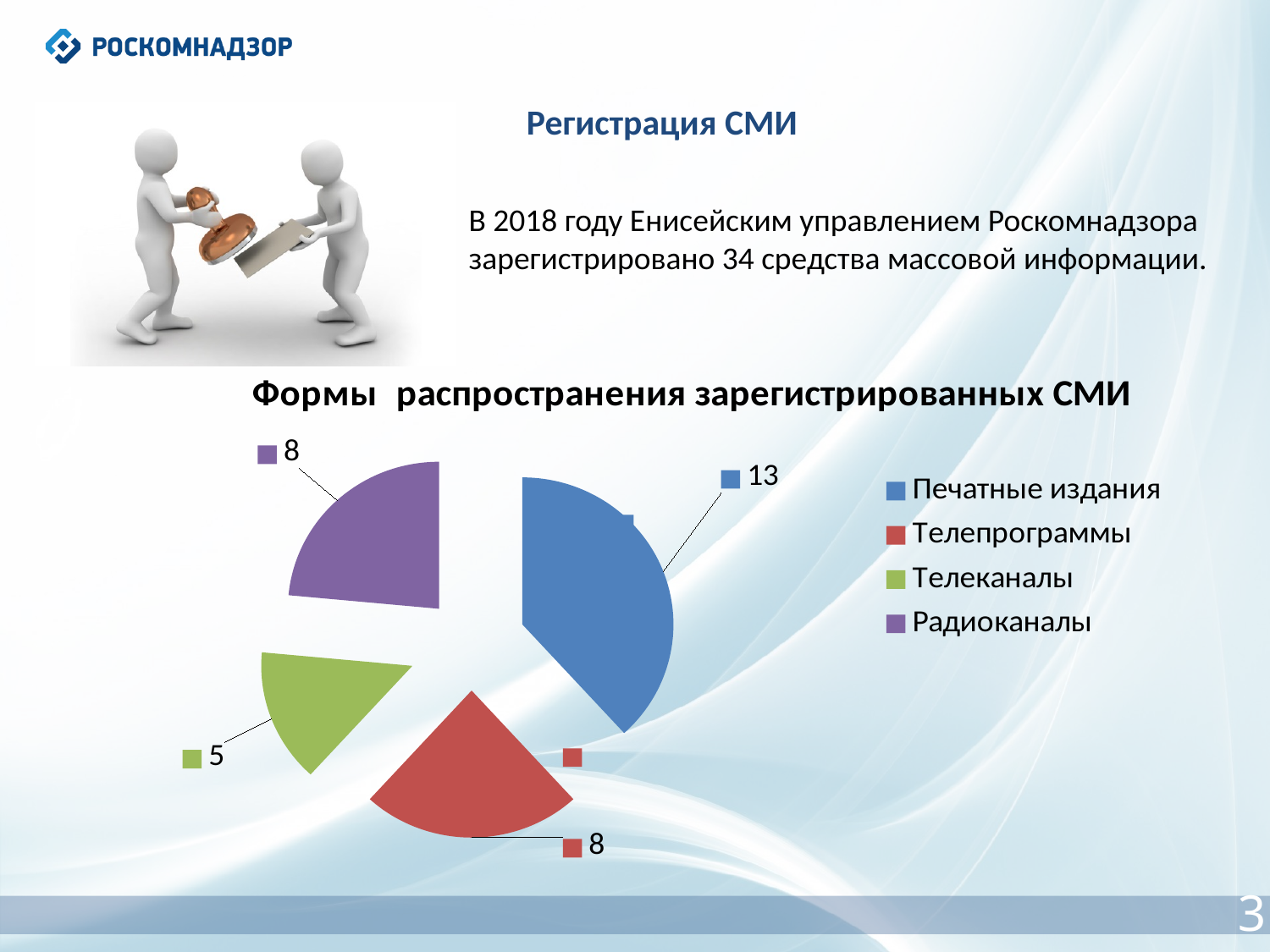
What type of chart is shown on the slide? pie chart What is the value for Печатные издания? 13 Which category has the largest slice? Печатные издания How many categories does the pie chart have? 4 Which category has the smallest slice? Телеканалы Which is larger, the value for Печатные издания or the value for Радиоканалы? Печатные издания Which colour represents Телеканалы in the pie chart? green What is the value for Телепрограммы? 8 What is the difference between the values for Печатные издания and Телеканалы? 8 What is the value for Радиоканалы? 8 What is the title of the chart? Формы распространения зарегистрированных СМИ What is the value for Телеканалы? 5